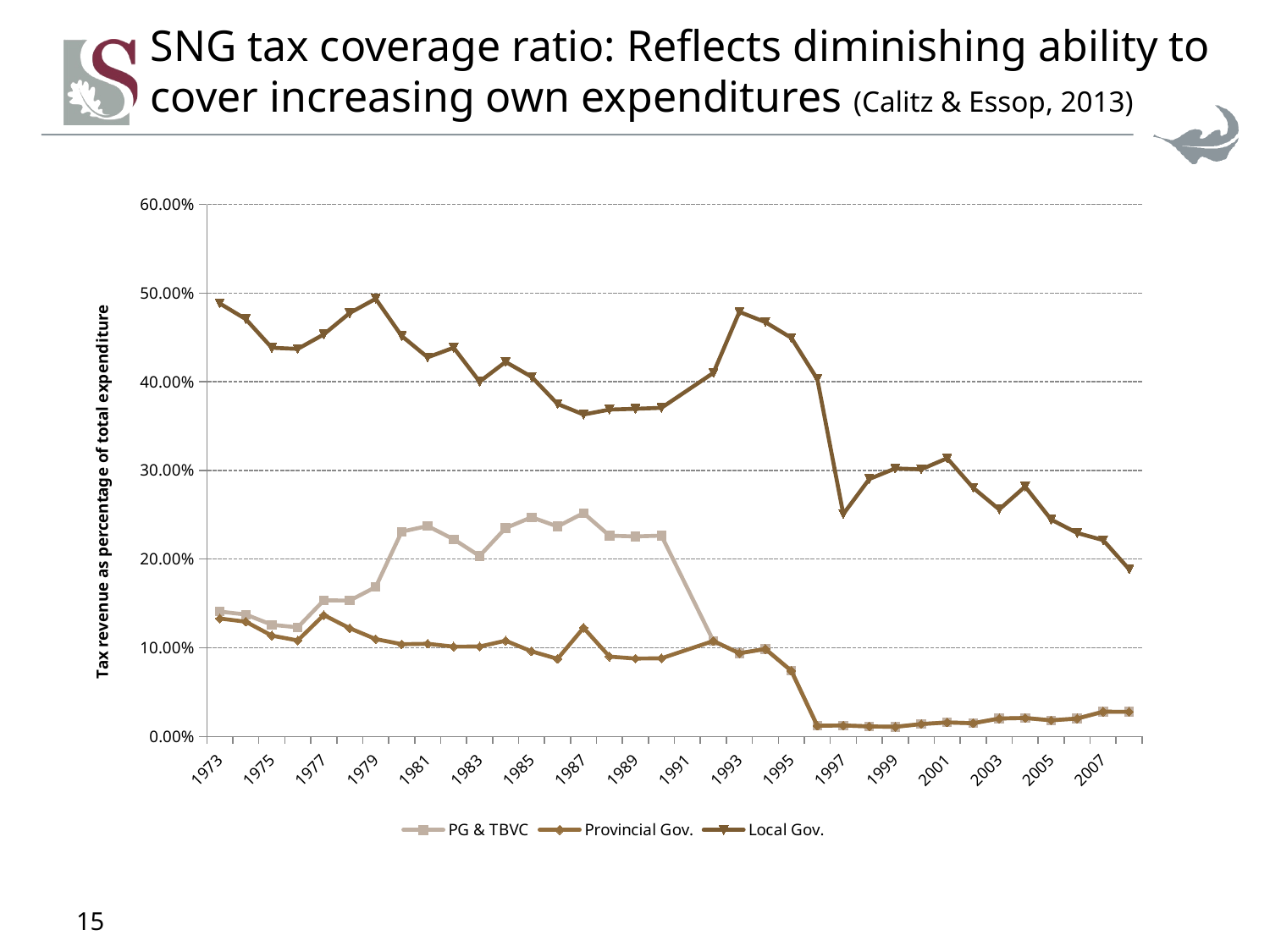
What are the three series named in the legend? PG & TBVC, Provincial Gov., Local Gov. In 1993, which series has the higher value: Local Gov. or Provincial Gov.? Local Gov. Is the value for PG & TBVC in 1987 greater or less than 20.00%? greater Does the Local Gov. series rise or fall between 1993 and 1997? fall Which series has the highest value in 1979? Local Gov. How many series does the chart's legend list? 3 Is the value for Local Gov. in 1973 greater or less than 40.00%? greater What is the title of the vertical axis? Tax revenue as percentage of total expenditure In 1985, which series has the higher value: PG & TBVC or Provincial Gov.? PG & TBVC Is the value for Provincial Gov. in 1999 greater or less than 10.00%? less What kind of chart is shown on the slide? line chart